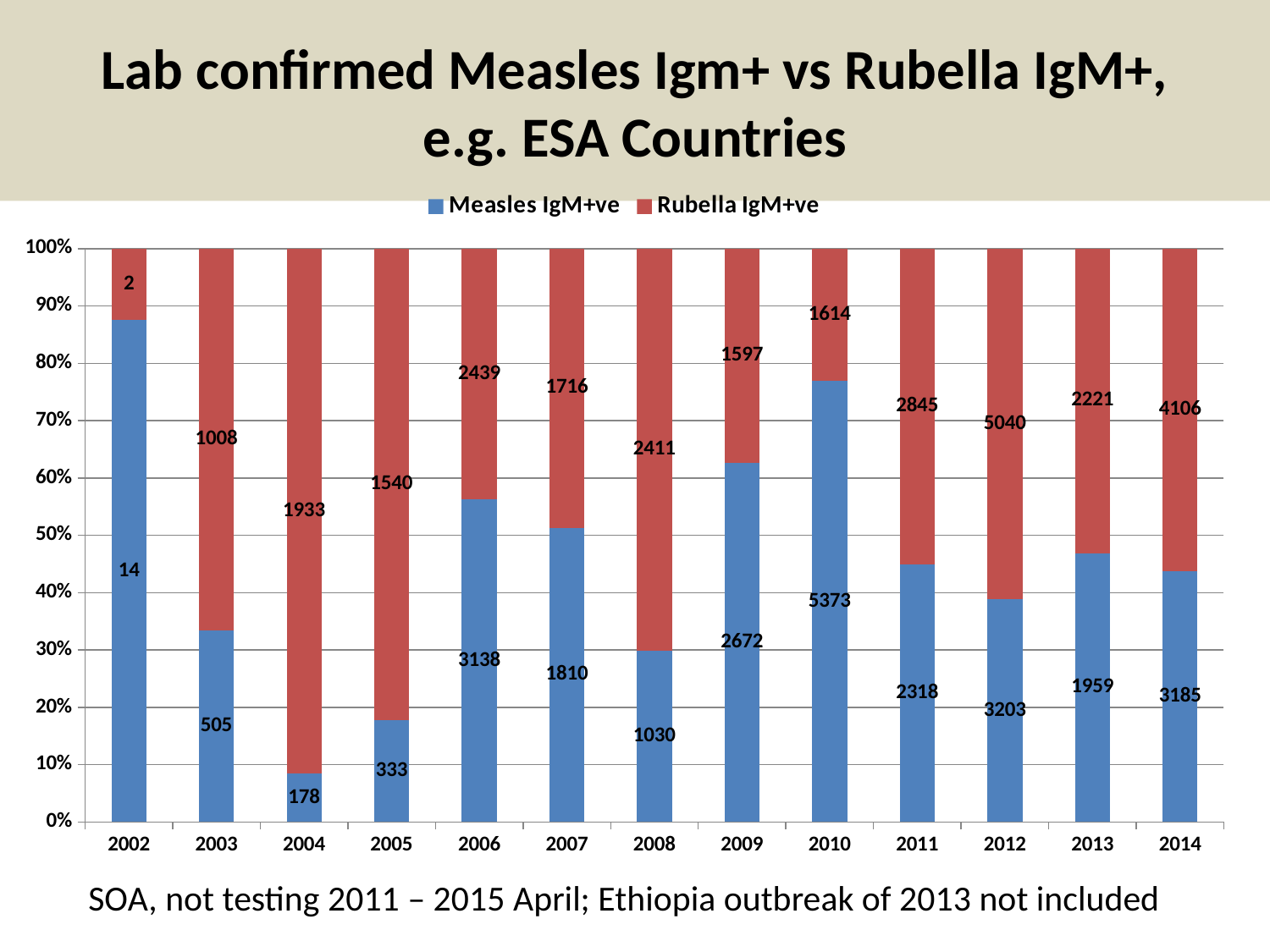
What is the Measles IgM+ve value for 2004? 178 Is the Measles IgM+ve share of the 2010 bar greater or less than 70%? greater Which is larger in 2006, the Measles IgM+ve value or the Rubella IgM+ve value? Measles IgM+ve How many series does the legend list? 2 What is the Measles IgM+ve value for 2010? 5373 Which year has the lowest Rubella IgM+ve value? 2002 Which year has the highest Measles IgM+ve value? 2010 What kind of chart is shown on the slide? Stacked bar chart What is the Rubella IgM+ve value for 2012? 5040 What is the difference between the Rubella IgM+ve and Measles IgM+ve values in 2014? 921 How many years are shown on the x axis? 13 What is the total of the Measles IgM+ve and Rubella IgM+ve values for 2010? 6987